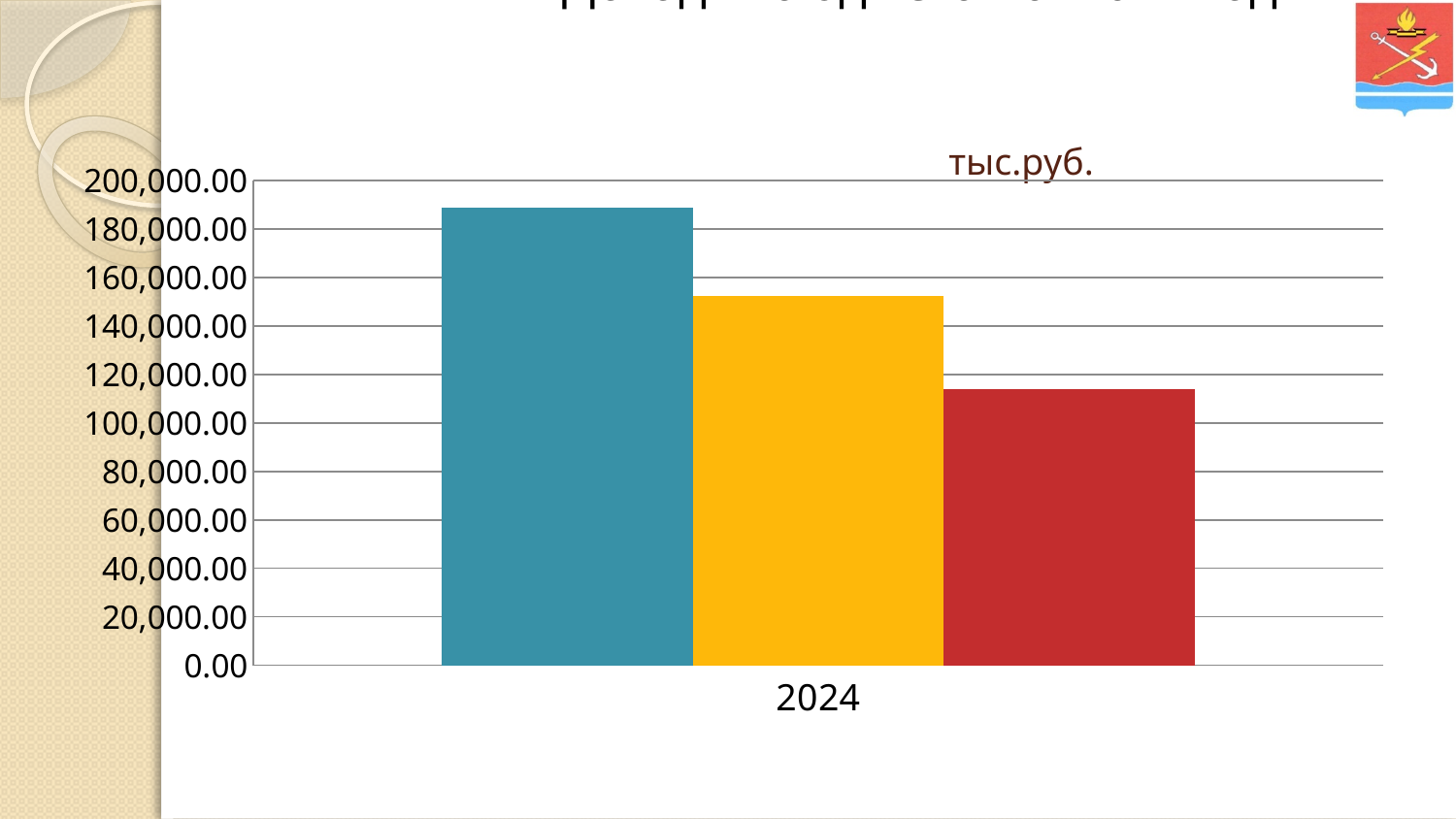
What is the highest value shown on the chart's y axis? 200,000.00 Is the value of the red bar greater or less than 100,000.00? greater Which is larger in the chart, the yellow bar or the red bar? yellow bar Is the value of the yellow bar greater or less than 160,000.00? less What is the category label shown on the x axis of the chart? 2024 How many categories are shown on the x axis of the chart? 1 Which bar is the tallest in the chart: the blue, the yellow or the red one? blue Which bar is the shortest in the chart: the blue, the yellow or the red one? red Is the value of the red bar greater or less than 120,000.00? less What kind of chart is shown on the slide? bar chart What unit label is printed above the chart's plot area? тыс.руб.